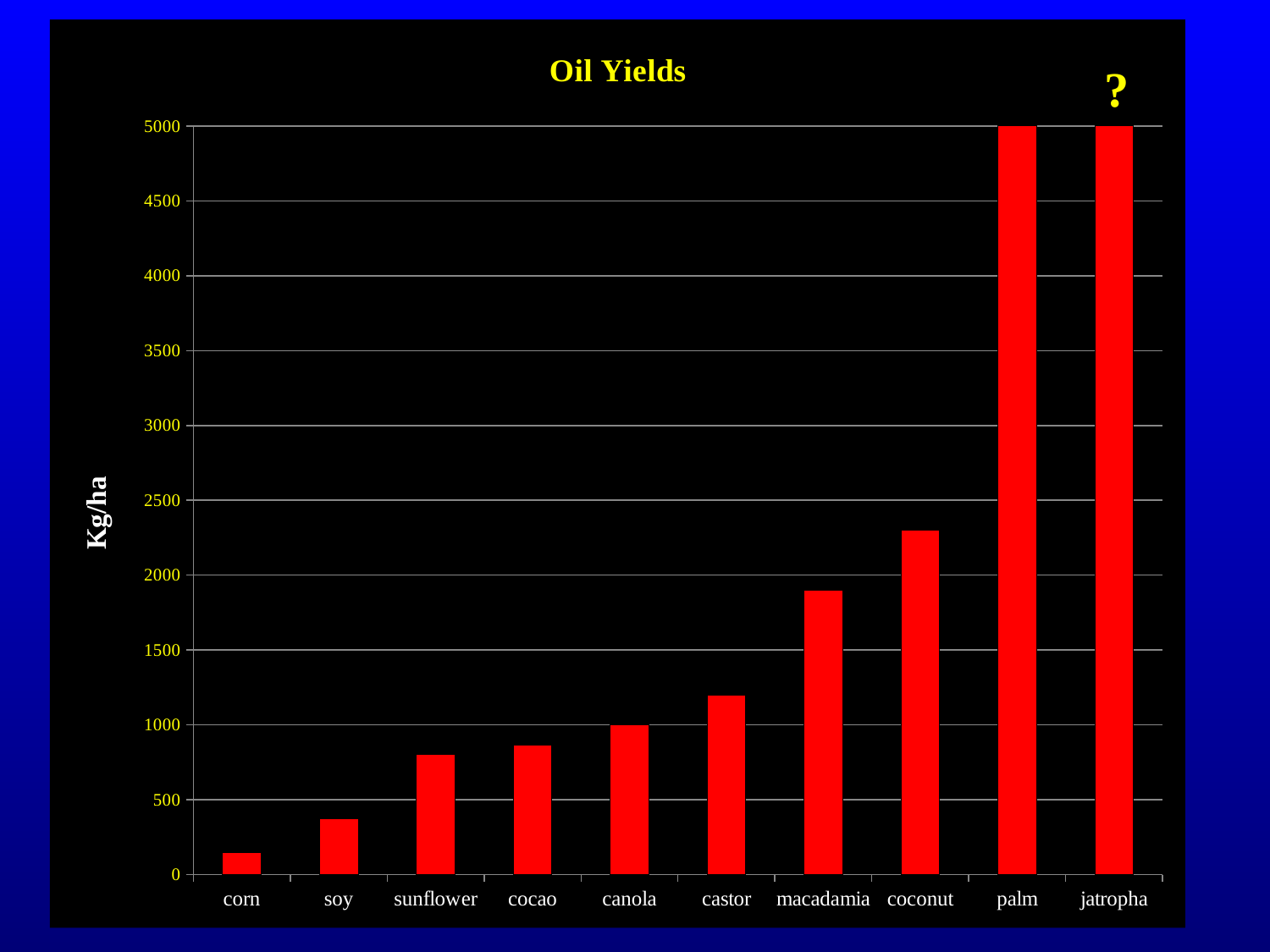
Which has the higher oil yield, coconut or macadamia? coconut How many crop categories are shown on the x axis? 10 What is the oil yield value for palm? 5000 Is the value for corn greater or less than 500? less Is the value for coconut greater or less than 2000? greater What is the title of the chart? Oil Yields Do the oil yield values generally rise or fall moving from left to right along the x axis? rise What kind of chart is shown on the slide? bar chart Which crop has the lowest oil yield? corn What is the label on the vertical axis of the chart? Kg/ha Is the value for macadamia greater or less than 2000? less